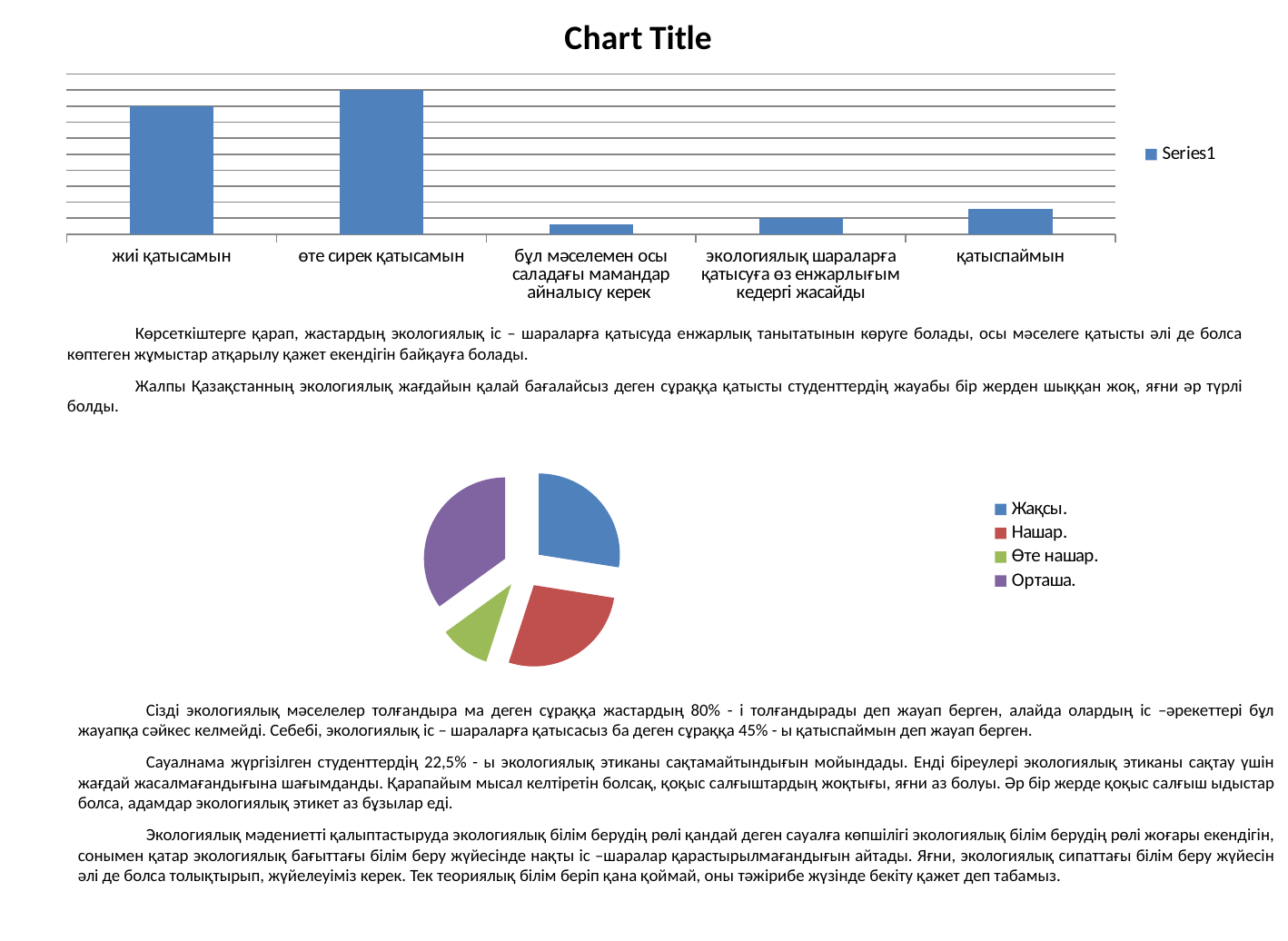
In the bottom pie chart, which category has the smallest slice? Өте нашар. In the top bar chart, which is larger: the bar for "экологиялық шараларға қатысуға өз енжарлығым кедергі жасайды" or the bar for "өте сирек қатысамын"? өте сирек қатысамын In the bottom pie chart, which slice is larger: "Нашар." or "Өте нашар."? Нашар. In the bottom pie chart, how many categories does the legend list? 4 In the top bar chart, which category has the highest bar? өте сирек қатысамын What is the name of the series in the legend of the top bar chart? Series1 In the top bar chart, which category has the lowest bar? бұл мәселемен осы саладағы мамандар айналысу керек In the top bar chart, how many categories are shown on the x axis? 5 What kind of chart is the top chart titled "Chart Title"? bar chart In the top bar chart, which is larger: the bar for "жиі қатысамын" or the bar for "қатыспаймын"? жиі қатысамын What kind of chart is the bottom chart on the slide? pie chart In the top bar chart, how many series does the legend list? 1